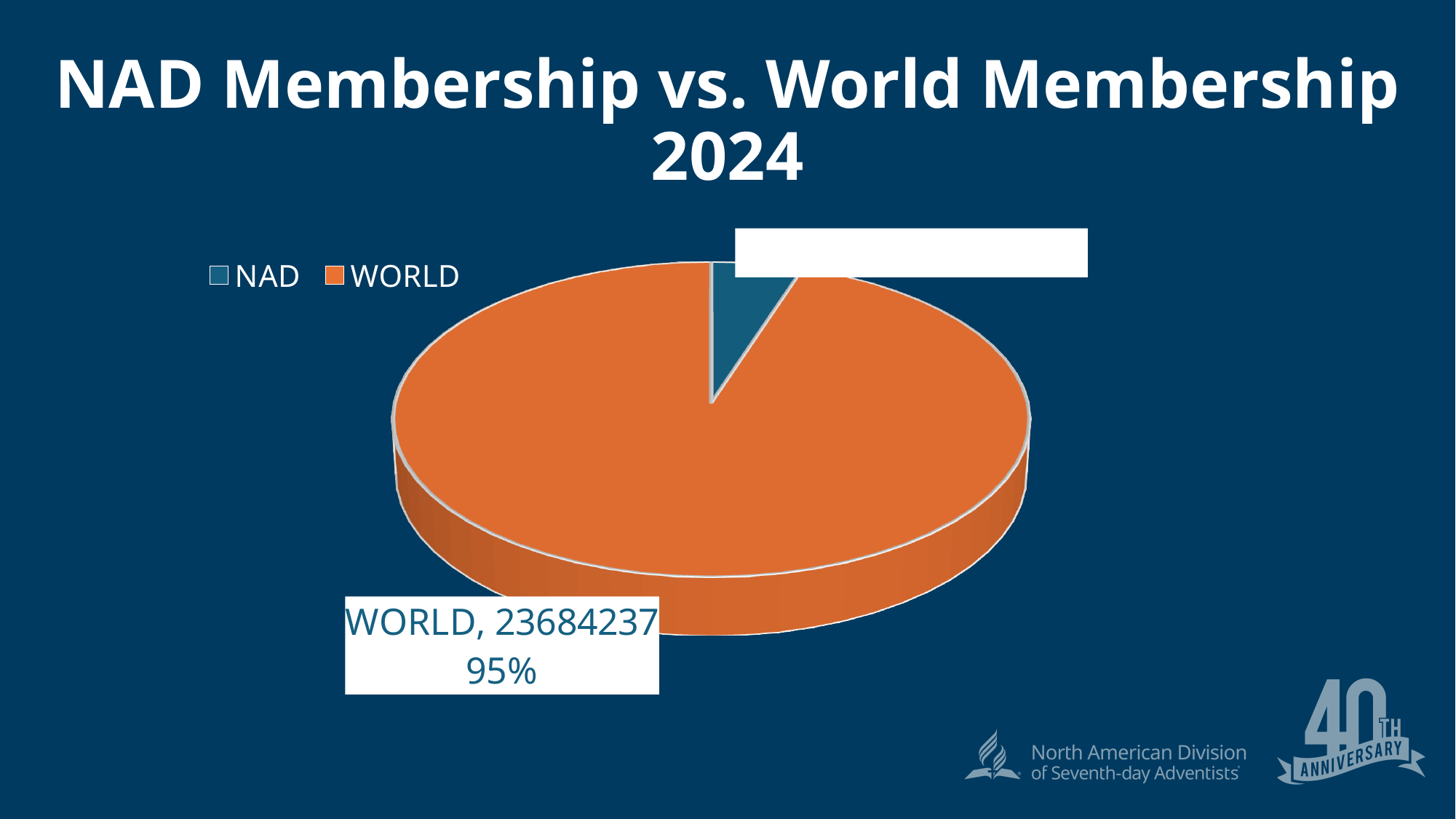
What colour is the WORLD slice in the pie chart? orange How many entries does the legend list? 2 How many slices does the pie chart have? 2 What is the title of the chart on the slide? NAD Membership vs. World Membership 2024 What kind of chart is shown on the slide? pie chart What share of the pie does the WORLD slice represent? 95% Which is larger, the NAD slice or the WORLD slice? WORLD Which slice is the largest in the pie chart? WORLD Which slice is the smallest in the pie chart? NAD What value is shown for the WORLD slice? 23684237